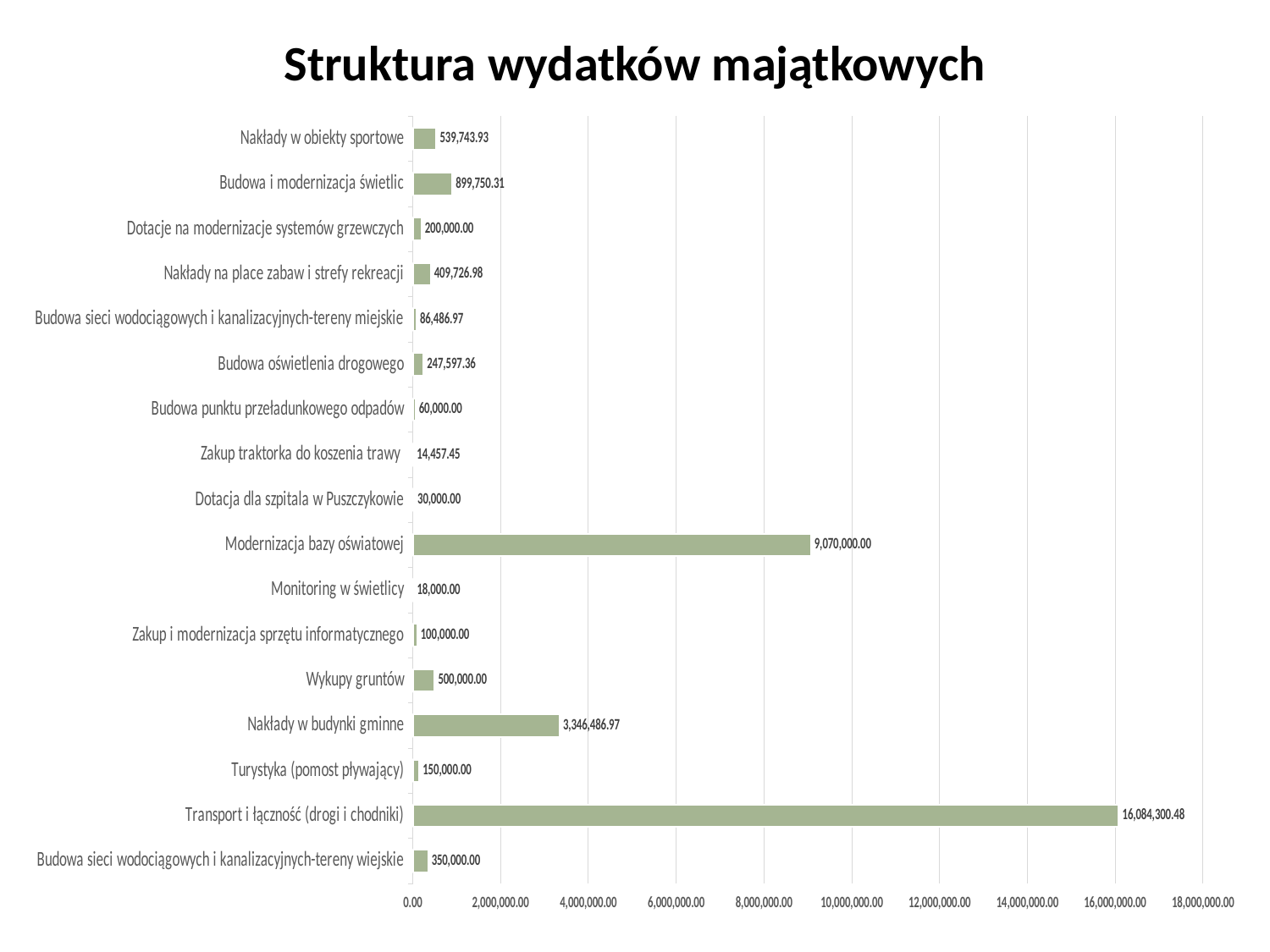
How many categories are shown in the chart? 17 What is the value for Zakup traktorka do koszenia trawy? 14,457.45 What is the difference between Wykupy gruntów and Budowa sieci wodociągowych i kanalizacyjnych-tereny wiejskie? 150,000.00 Is the value for Nakłady w budynki gminne greater or less than 4,000,000.00? less What is the difference between Transport i łączność (drogi i chodniki) and Modernizacja bazy oświatowej? 7,014,300.48 What is the value for Nakłady w budynki gminne? 3,346,486.97 Which category has the lowest value? Zakup traktorka do koszenia trawy What kind of chart is shown on the slide? Bar chart What is the value for Modernizacja bazy oświatowej? 9,070,000.00 Which is larger, Budowa i modernizacja świetlic or Nakłady w obiekty sportowe? Budowa i modernizacja świetlic Which category has the highest value? Transport i łączność (drogi i chodniki) What is the value for Transport i łączność (drogi i chodniki)? 16,084,300.48